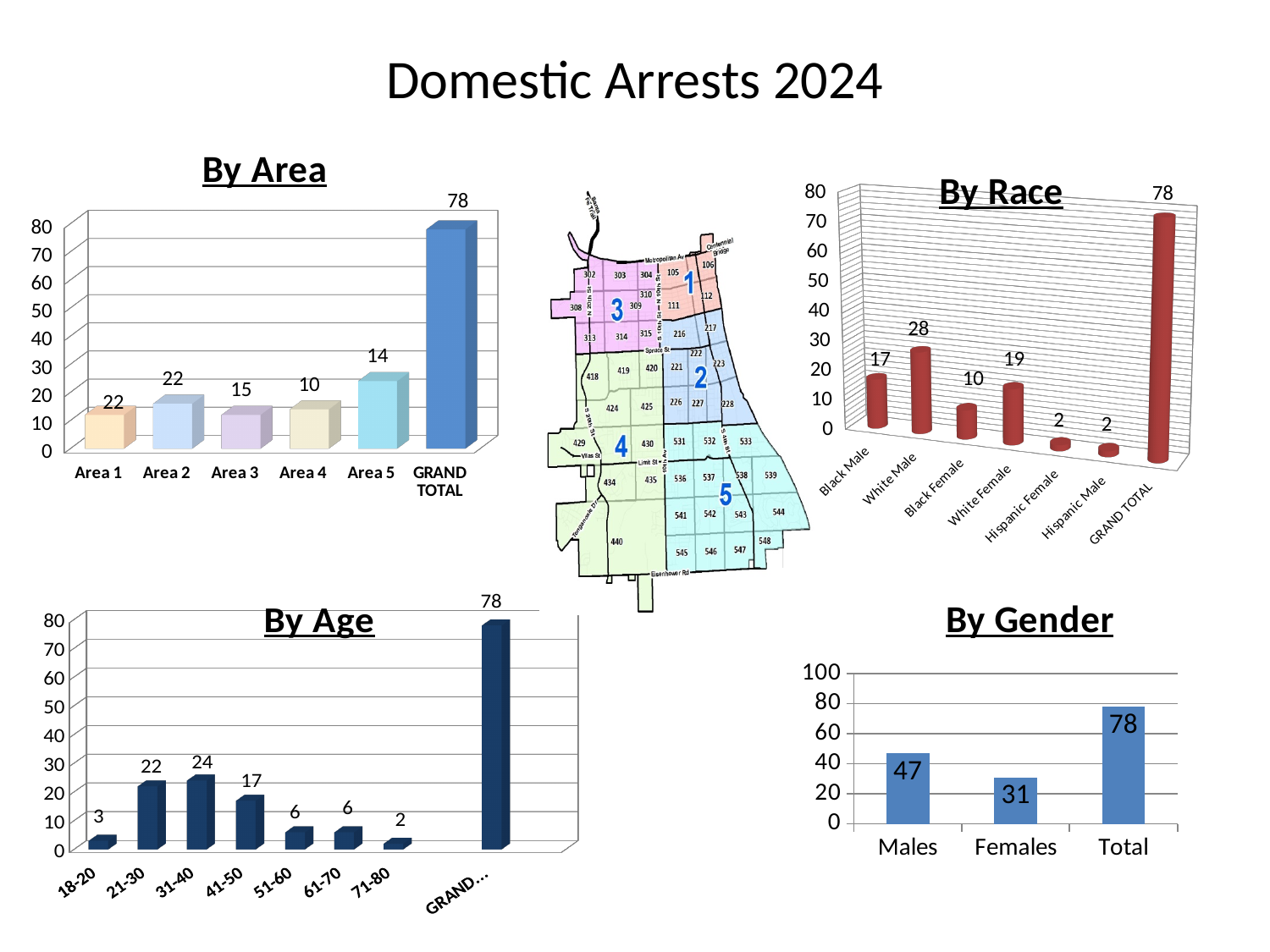
In the By Age chart, how many age groups are shown, excluding the grand total? 7 In the By Race chart, what is the value for White Female? 19 In the By Gender chart, what is the value for Females? 31 In the By Age chart, what is the value for the 41-50 age group? 17 In the By Race chart, which race/gender category (excluding the grand total) has the highest value? White Male In the By Area chart, what is the difference between Area 1 and Area 3? 7 In the By Race chart, which is larger, Black Male or Black Female? Black Male In the By Gender chart, what is the difference between Males and Females? 16 What kind of chart is the By Gender chart? Bar chart In the By Age chart, which age group has the highest value? 31-40 In the By Area chart, which area (excluding the grand total) has the lowest value? Area 4 In the By Area chart, what is the value for Area 5? 14